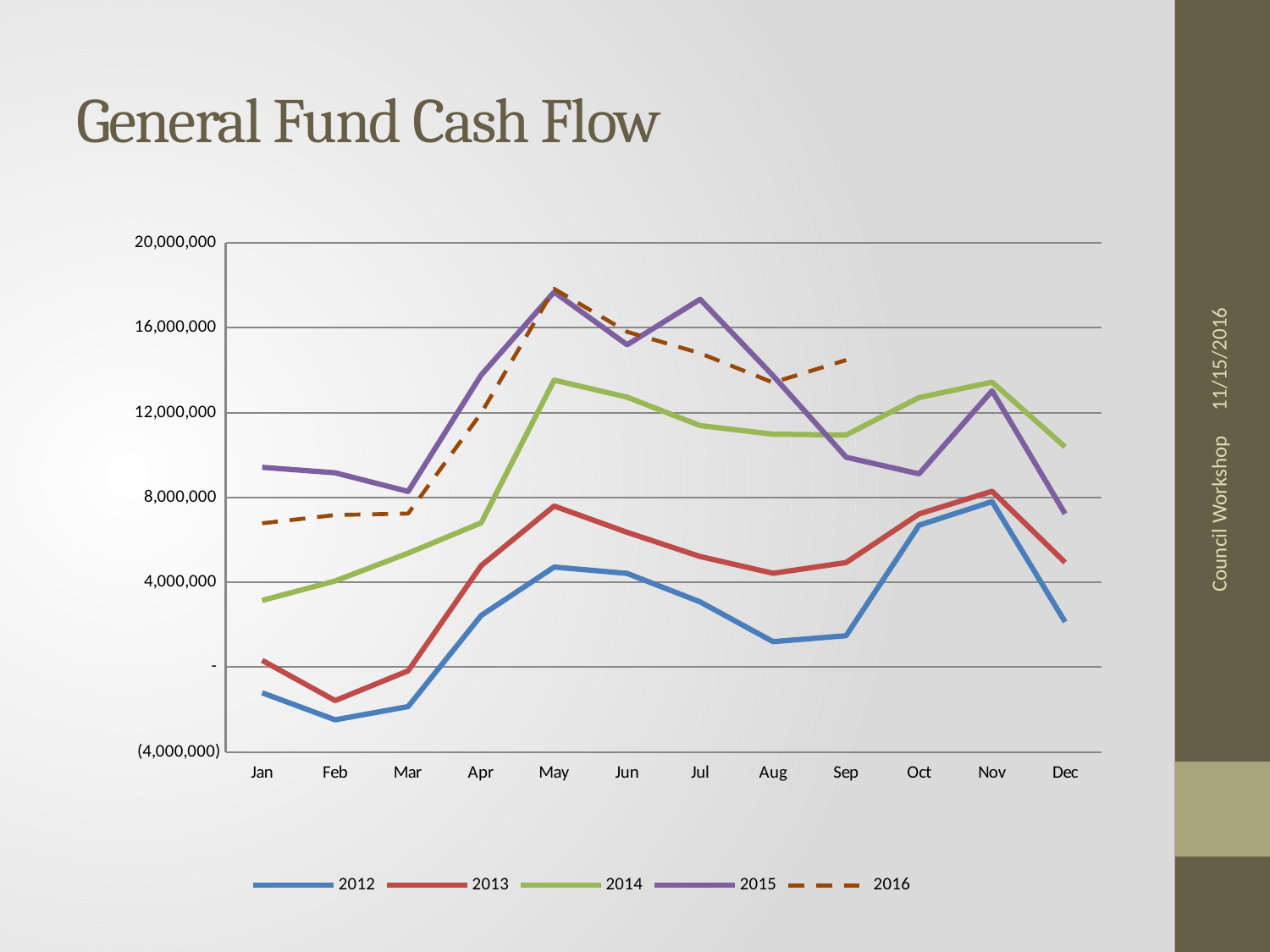
How many months are shown along the x axis? 12 In which month does the 2012 series reach its highest value? Nov Does the 2014 series rise or fall from Jan to May? rise Which series is drawn with a dashed line? 2016 In Jul, which series has the larger value, 2015 or 2014? 2015 How many series does the legend list? 5 What kind of chart is shown on the slide? line chart In Dec, which series has the larger value, 2014 or 2015? 2014 Is the value for 2016 in Sep greater or less than 12,000,000? greater Is the value for 2015 in May greater or less than 16,000,000? greater Is the value for 2014 in Jan greater or less than 4,000,000? less In which month does the 2012 series reach its lowest value? Feb